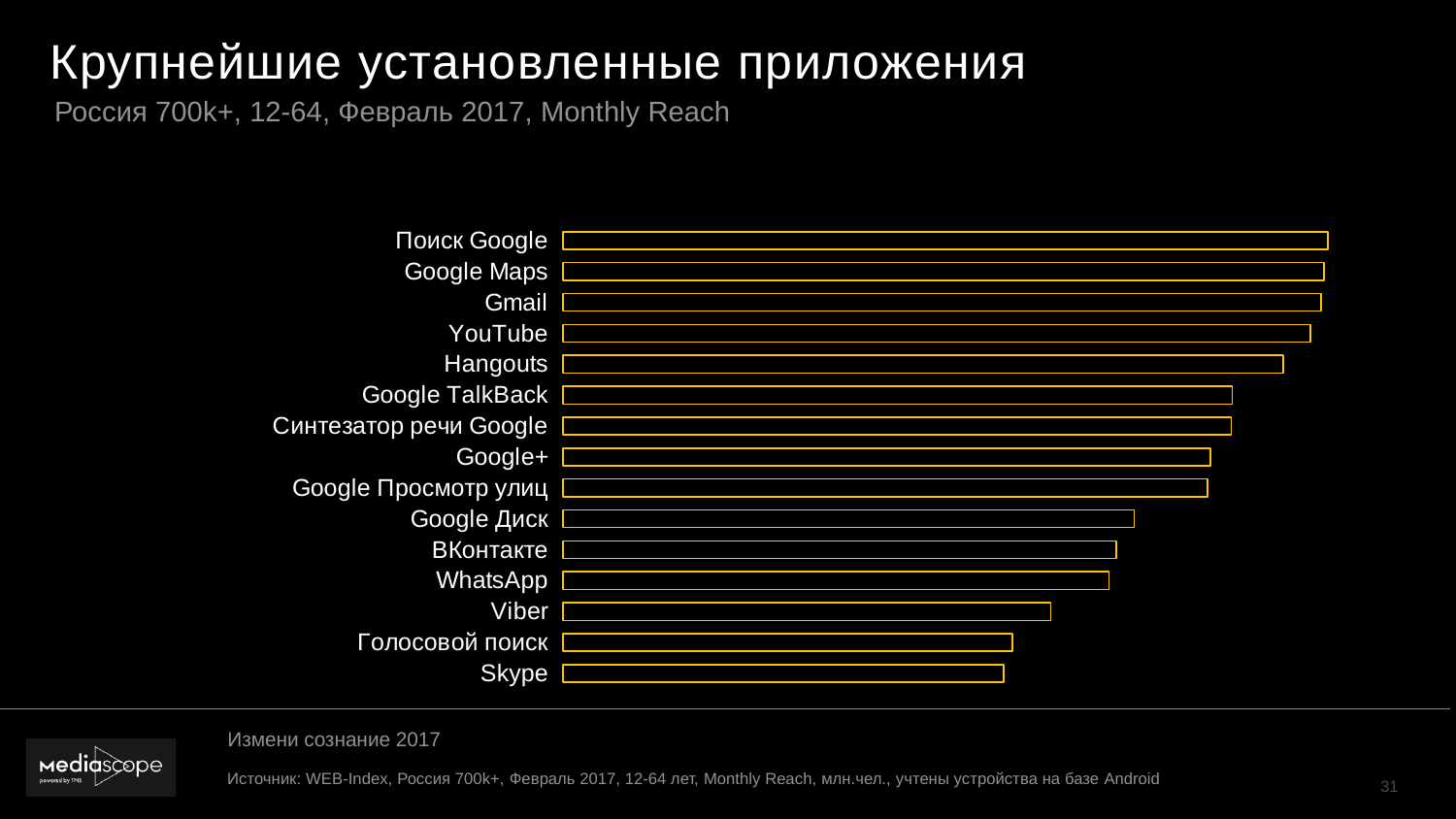
Which has the larger value, Gmail or Google+? Gmail What is the title of the slide? Крупнейшие установленные приложения Which has the larger value, YouTube or Hangouts? YouTube What kind of chart is shown on the slide? bar chart How many applications are listed in the chart? 15 Which has the larger value, Google Диск or WhatsApp? Google Диск Which application has the longest bar in the chart? Поиск Google Are the bars ordered from longest to shortest going down the chart, or from shortest to longest? longest to shortest Which application is listed at the bottom of the chart? Skype